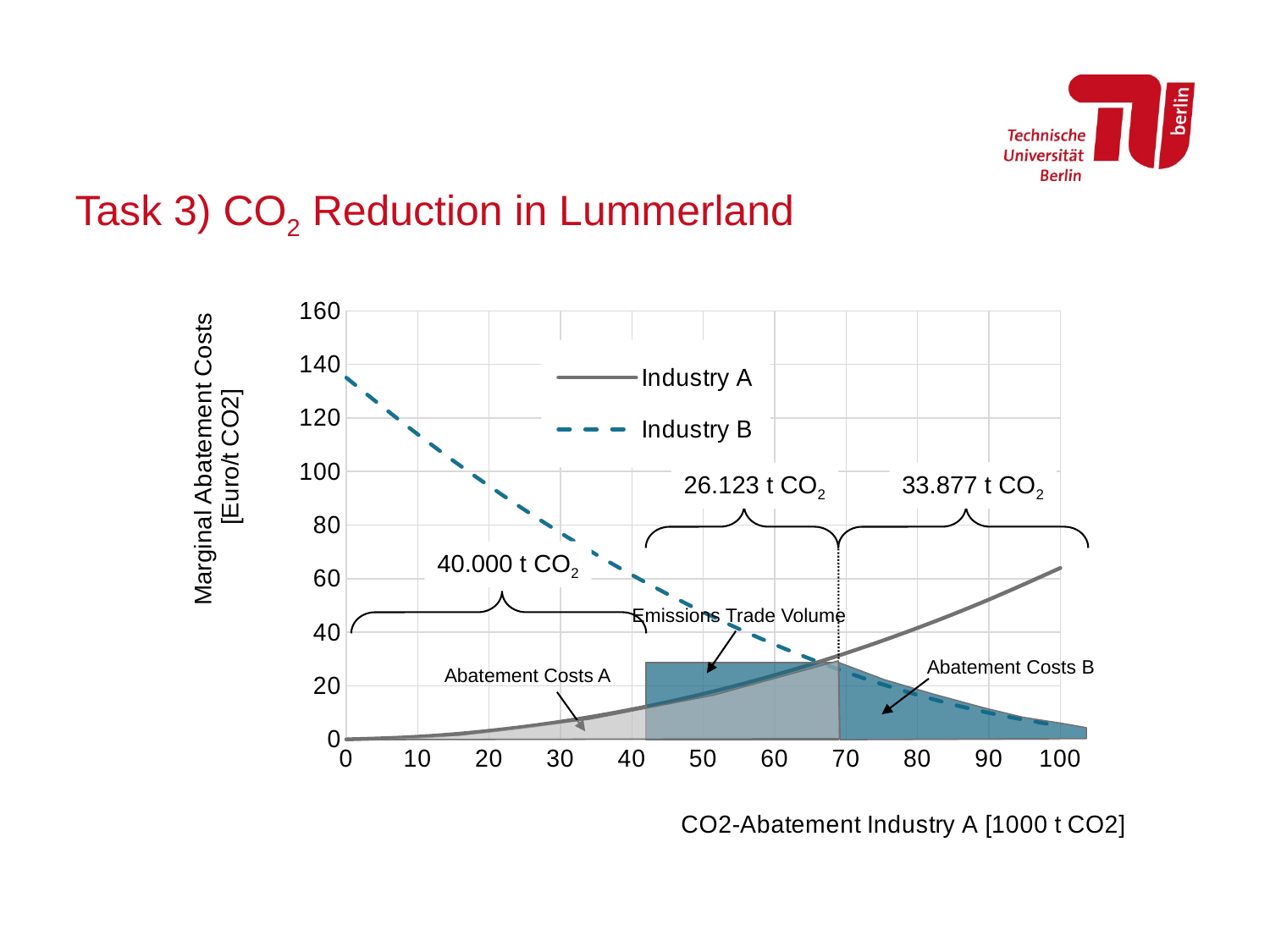
What is the label of the y axis? Marginal Abatement Costs [Euro/t CO2] Is the value for Industry A at 100 on the x axis greater or less than 80? less Do the values for Industry B rise or fall along the x axis? fall How many series does the legend list? 2 Is the value for Industry A at 40 on the x axis greater or less than 40? less Do the values for Industry A rise or fall as CO2 abatement increases along the x axis? rise At 90 on the x axis, which series has the larger value, Industry A or Industry B? Industry A Is the value for Industry B at 100 on the x axis greater or less than 20? less Which two series are listed in the legend? Industry A and Industry B What kind of chart is shown on the slide? line chart At 20 on the x axis, which series has the larger value, Industry A or Industry B? Industry B